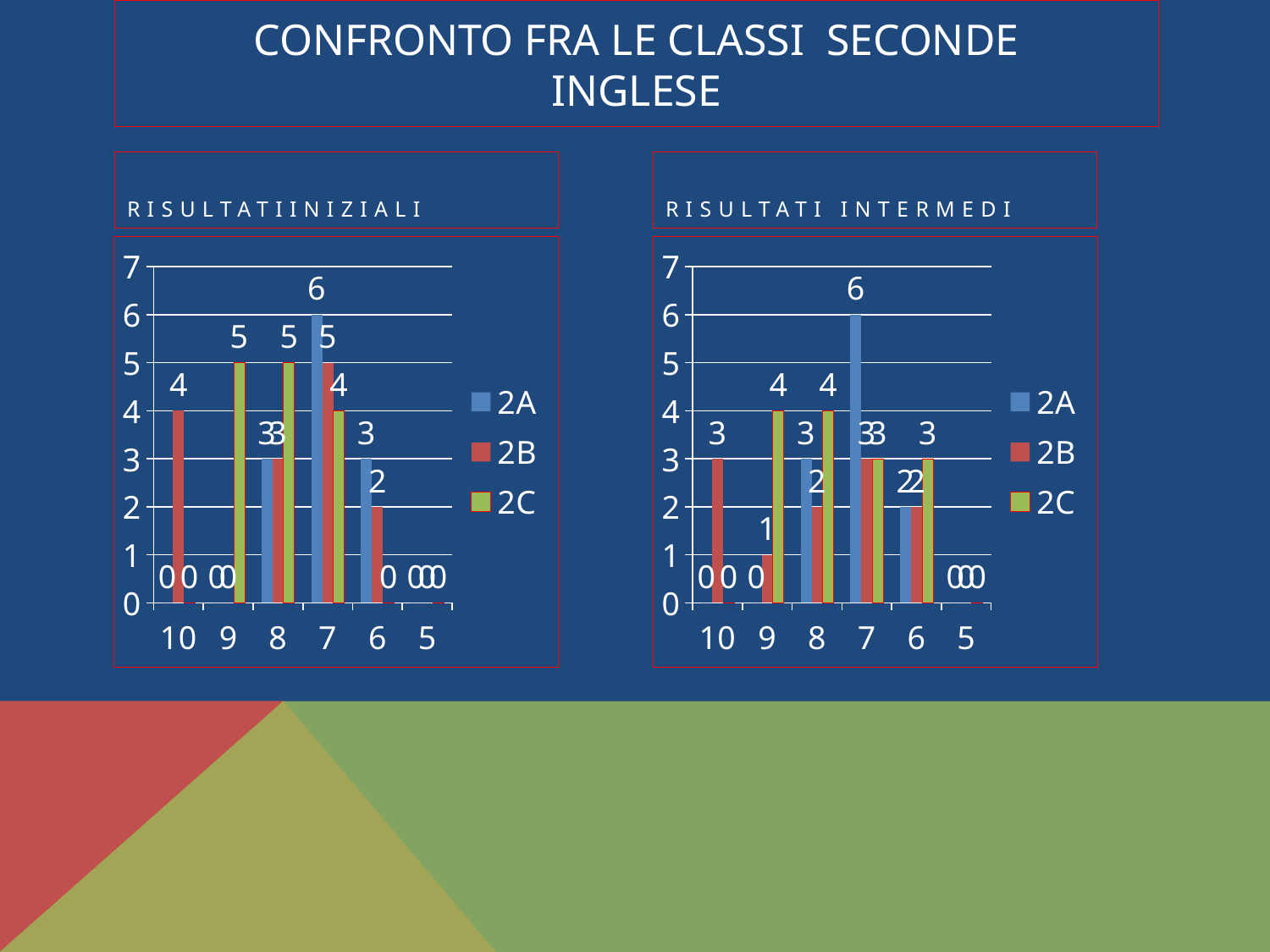
In the RISULTATI INIZIALI chart, what is the difference between 2A and 2B at category 6? 1 In the RISULTATI INIZIALI chart, what is the value for 2A at category 7? 6 What kind of chart is the RISULTATI INIZIALI chart? Bar chart In the RISULTATI INTERMEDI chart, what is the difference between 2A and 2B at category 7? 3 In the RISULTATI INIZIALI chart, what is the value for 2C at category 9? 5 In the RISULTATI INIZIALI chart, which category has the highest value for 2A? 7 In the RISULTATI INTERMEDI chart, what is the value for 2A at category 7? 6 In the RISULTATI INTERMEDI chart, which is larger at category 8: 2A or 2C? 2C In the RISULTATI INIZIALI chart, what is the value for 2B at category 10? 4 How many series does the legend of the RISULTATI INTERMEDI chart list? 3 In the RISULTATI INTERMEDI chart, what is the value for 2C at category 8? 4 In the RISULTATI INTERMEDI chart, what is the value for 2B at category 9? 1